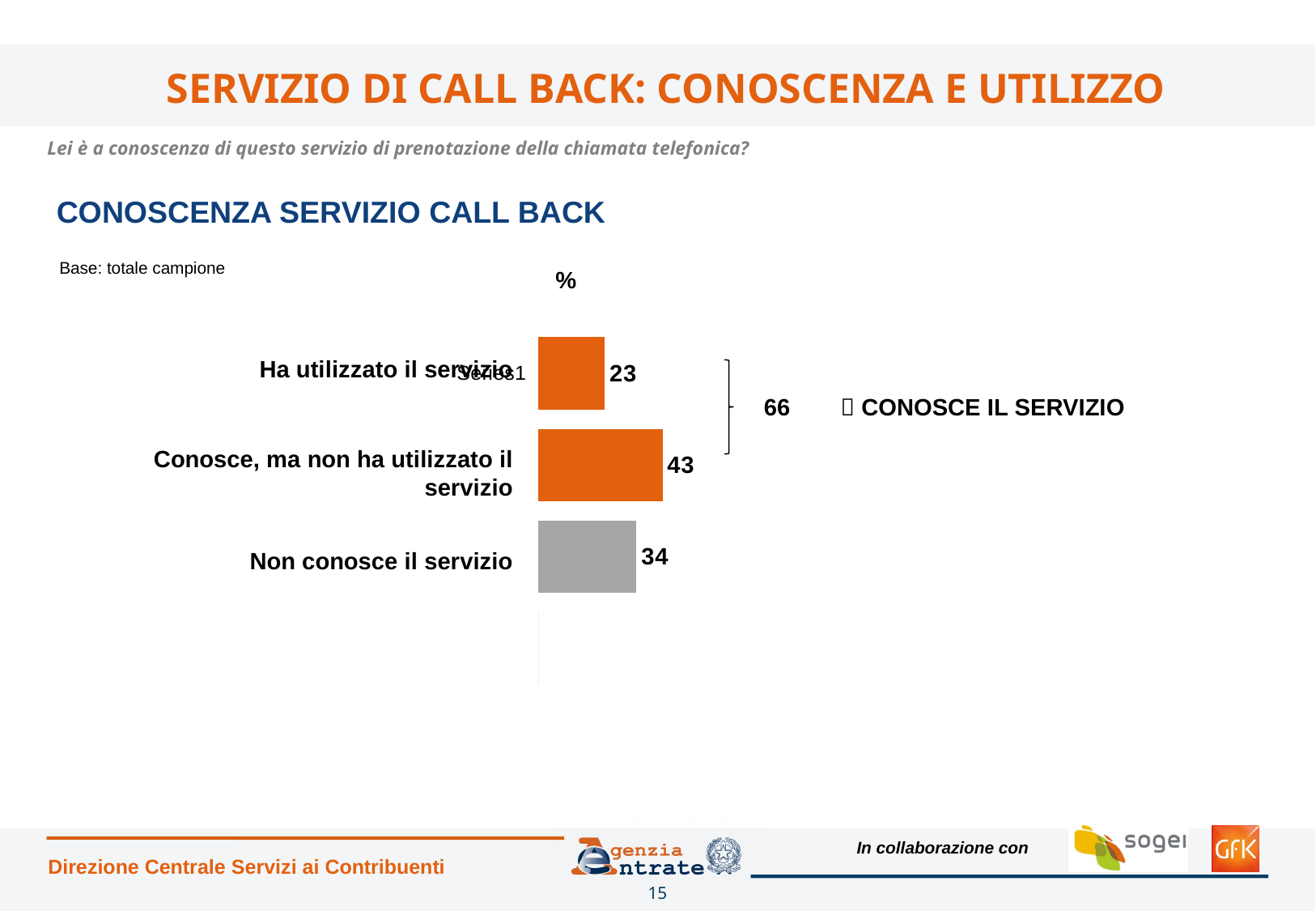
What is the value for "Conosce, ma non ha utilizzato il servizio"? 43 What is the difference between the values for "Non conosce il servizio" and "Ha utilizzato il servizio"? 11 What is the value for "Non conosce il servizio"? 34 Which category has the highest value? Conosce, ma non ha utilizzato il servizio What combined value is shown by the bracket labelled "CONOSCE IL SERVIZIO"? 66 What is the title of the chart? CONOSCENZA SERVIZIO CALL BACK What kind of chart is shown on the slide? Bar chart What is the value for "Ha utilizzato il servizio"? 23 Which is larger, the value for "Non conosce il servizio" or the value for "Ha utilizzato il servizio"? Non conosce il servizio What is the difference between the values for "Conosce, ma non ha utilizzato il servizio" and "Non conosce il servizio"? 9 Which category has the lowest value? Ha utilizzato il servizio How many categories are shown in the chart? 3